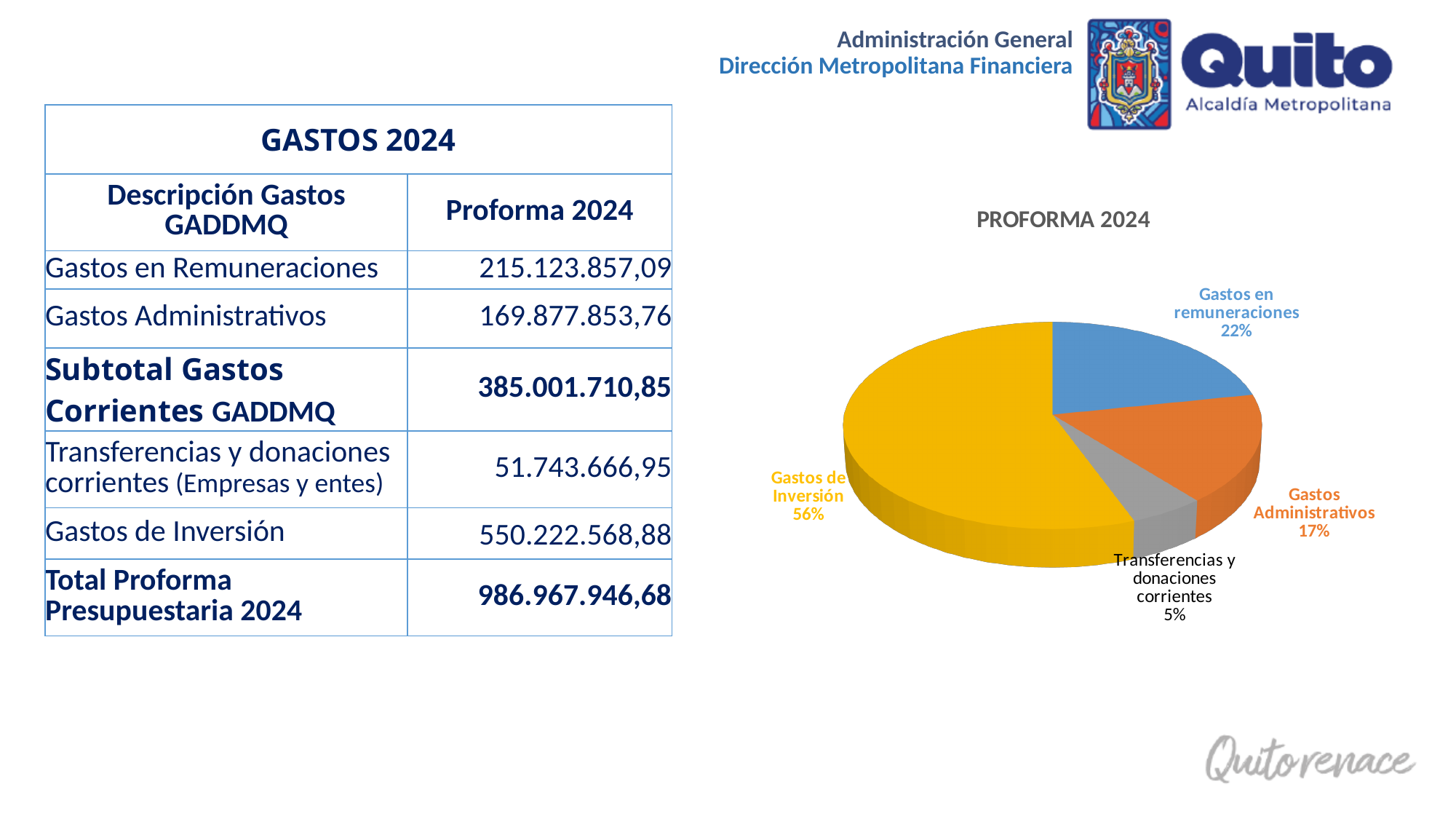
What share of the pie does Transferencias y donaciones corrientes represent? 5% Which slice of the pie chart is the largest? Gastos de Inversión What percentage is shown for Gastos en remuneraciones in the pie chart? 22% What is the difference in percentage points between Gastos de Inversión and Gastos en remuneraciones in the pie chart? 34 What colour is the Gastos de Inversión slice in the pie chart? yellow What share of the pie does Gastos de Inversión represent? 56% Which slice of the pie chart is the smallest? Transferencias y donaciones corrientes Which is larger in the pie chart, Gastos en remuneraciones or Gastos Administrativos? Gastos en remuneraciones How many slices does the pie chart have? 4 What is the title of the pie chart? PROFORMA 2024 What percentage is shown for Gastos Administrativos in the pie chart? 17% What kind of chart is shown on the slide? pie chart